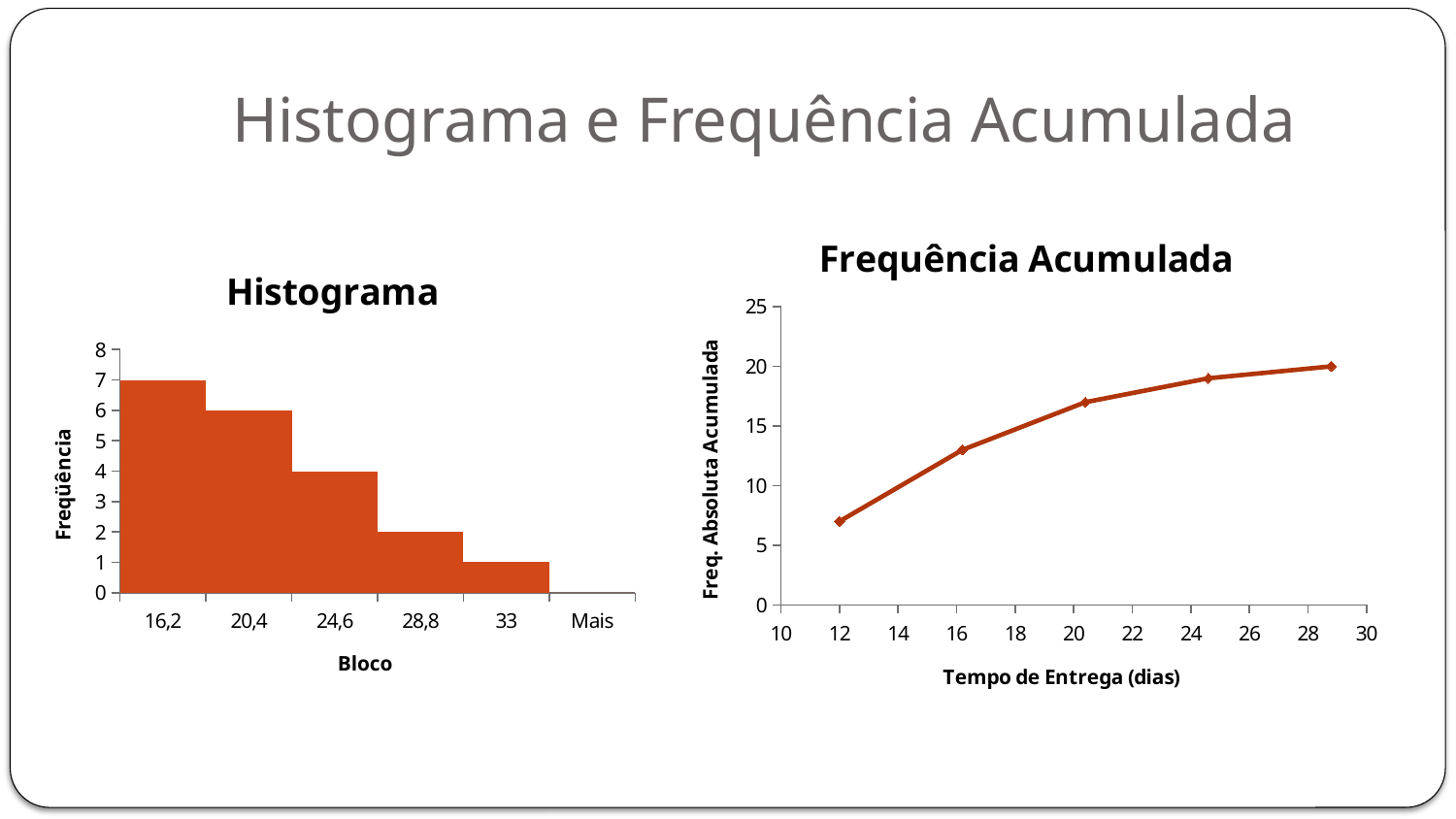
What is the y-axis label of the Frequência Acumulada chart? Freq. Absoluta Acumulada In the Histograma chart, what is the frequency for the 24,6 block? 4 In the Histograma chart, what is the frequency for the 16,2 block? 7 In the Frequência Acumulada chart, is the cumulative frequency at 12 days greater or less than 10? less In the Histograma chart, which has a higher frequency, the 24,6 block or the 28,8 block? 24,6 In the Histograma chart, what is the frequency for the 33 block? 1 In the Histograma chart, what is the difference in frequency between the 20,4 block and the 28,8 block? 4 In the Histograma chart, which block has the highest frequency? 16,2 In the Frequência Acumulada chart, is the cumulative frequency at about 20 days greater or less than 15? greater What kind of chart is the Histograma chart? bar chart In the Histograma chart, do the frequencies rise or fall from left to right along the x axis? fall How many blocks are shown on the x axis of the Histograma chart? 6